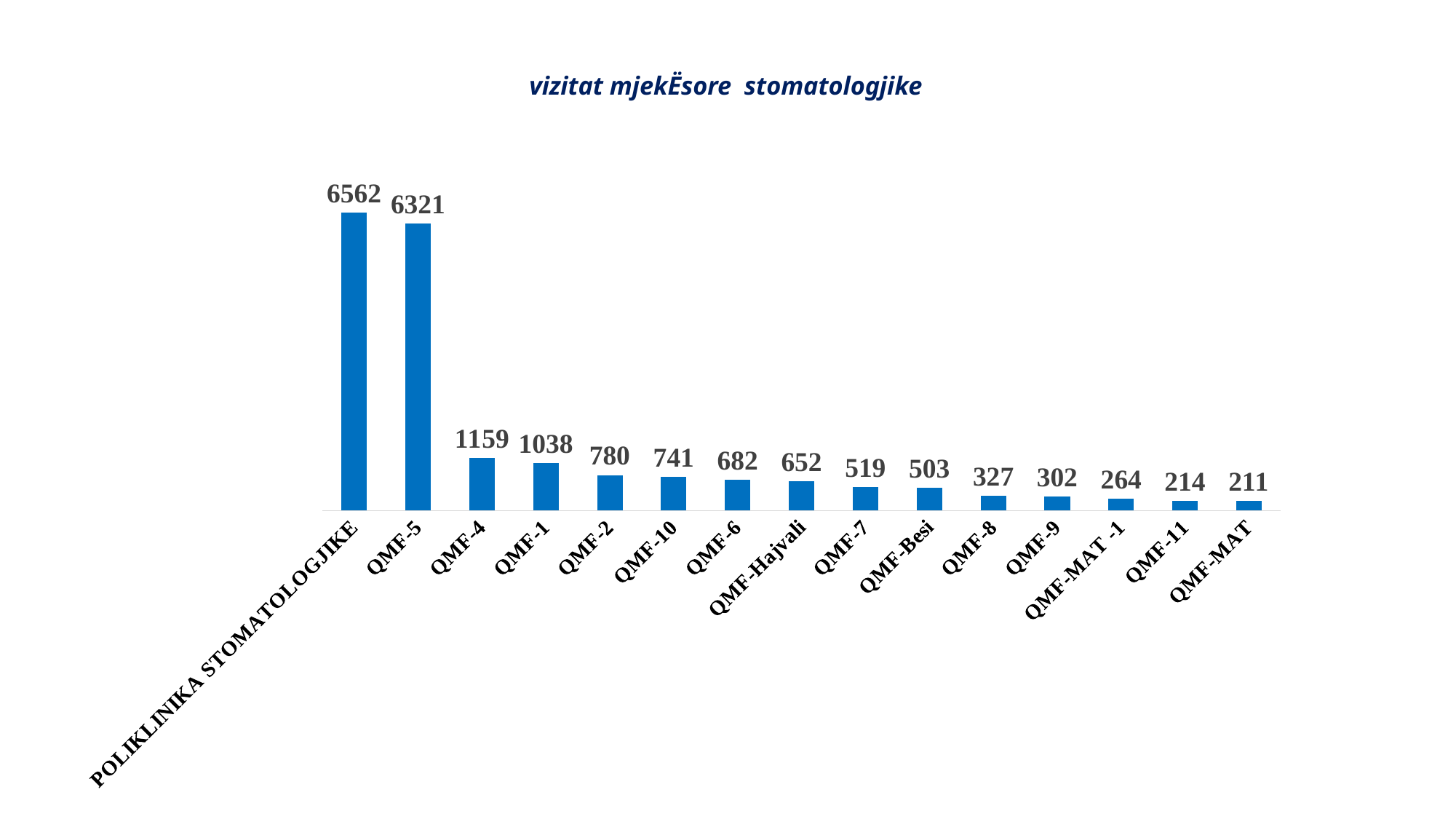
Which category has the lowest value? QMF-MAT What is the difference between the values for POLIKLINIKA STOMATOLOGJIKE and QMF-5? 241 What is the difference between the values for QMF-4 and QMF-1? 121 What is the title of the chart? vizitat mjekËsore stomatologjike What is the value for QMF-Hajvali? 652 What is the value for QMF-5? 6321 Which category has the highest value? POLIKLINIKA STOMATOLOGJIKE Which is larger, the value for QMF-2 or the value for QMF-10? QMF-2 How many categories are shown in the chart? 15 Do the values rise or fall from left to right along the x axis? fall What kind of chart is shown on the slide? bar chart What is the value for QMF-MAT -1? 264